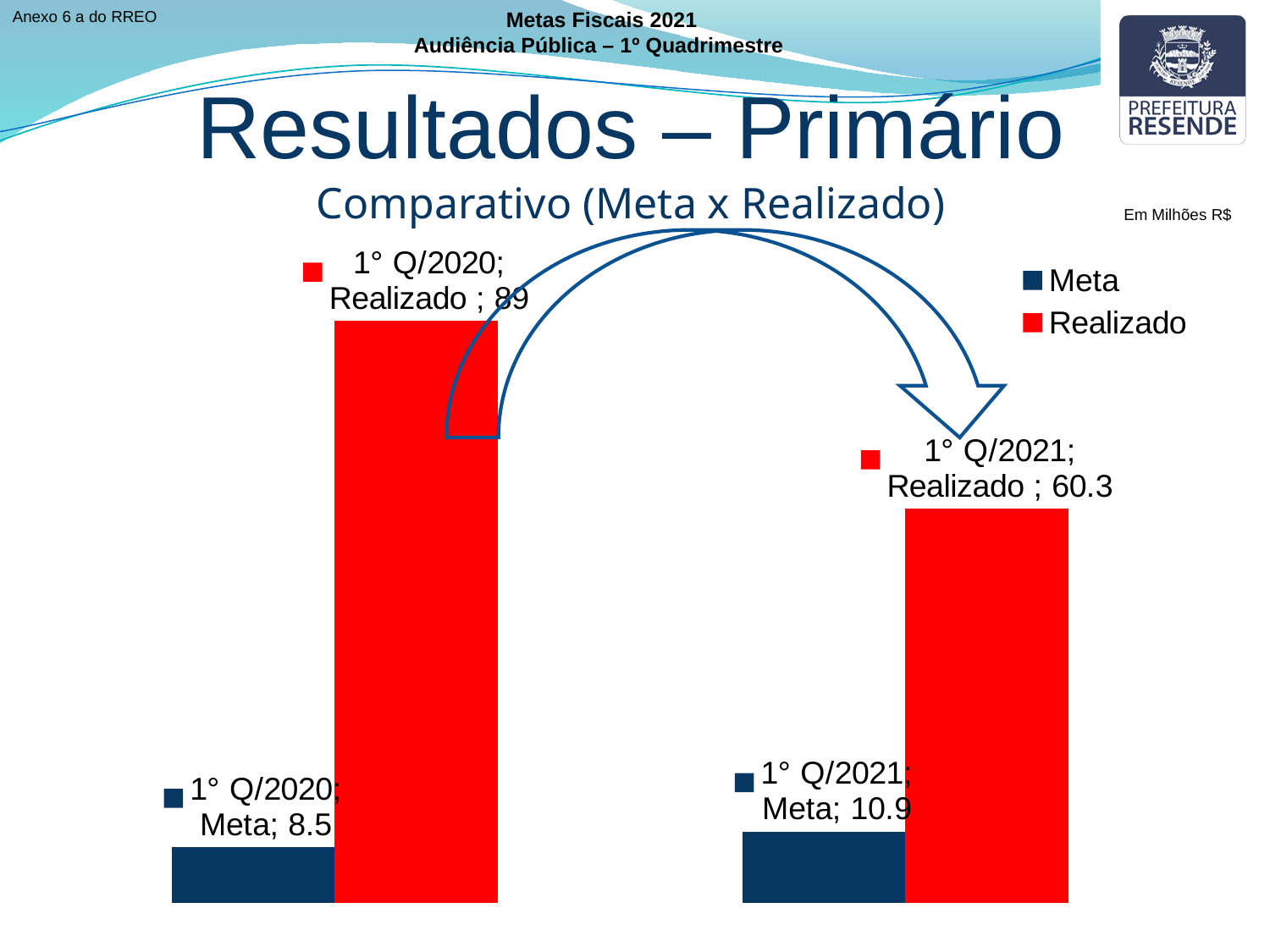
How many series does the legend list? 2 What is the Meta value for 1° Q/2020? 8.5 Which is larger for 1° Q/2021, Meta or Realizado? Realizado What is the difference between the Realizado values for 1° Q/2020 and 1° Q/2021? 28.7 What is the Realizado value for 1° Q/2020? 89 Which category has the lowest Meta value? 1° Q/2020 What kind of chart is shown on the slide? Bar chart What is the Meta value for 1° Q/2021? 10.9 Which category has the highest Realizado value? 1° Q/2020 What is the title of the chart? Comparativo (Meta x Realizado) What is the difference between the Meta values for 1° Q/2021 and 1° Q/2020? 2.4 What is the Realizado value for 1° Q/2021? 60.3